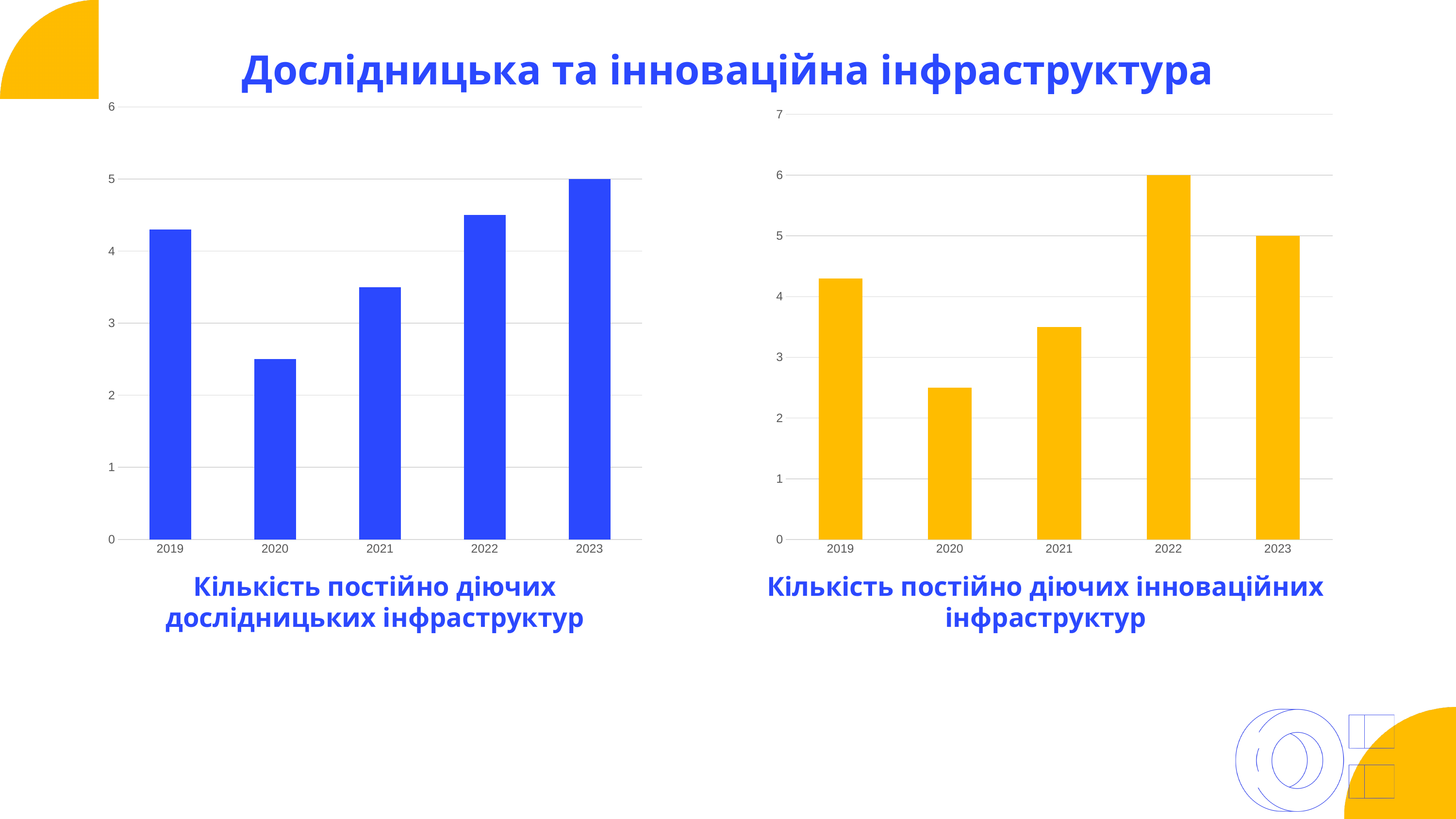
In the right chart (Кількість постійно діючих інноваційних інфраструктур), what is the value for 2023? 5 In the right chart (Кількість постійно діючих інноваційних інфраструктур), which year has the lowest value? 2020 In the left chart (Кількість постійно діючих дослідницьких інфраструктур), which is larger, the value for 2021 or the value for 2022? 2022 In the right chart (Кількість постійно діючих інноваційних інфраструктур), what is the difference between the values for 2022 and 2023? 1 In the left chart (Кількість постійно діючих дослідницьких інфраструктур), which year has the lowest value? 2020 In the left chart (Кількість постійно діючих дослідницьких інфраструктур), is the value for 2020 greater or less than 3? less In the right chart (Кількість постійно діючих інноваційних інфраструктур), which year has the highest value? 2022 In the left chart (Кількість постійно діючих дослідницьких інфраструктур), which year has the highest value? 2023 In the right chart (Кількість постійно діючих інноваційних інфраструктур), what is the value for 2022? 6 In the left chart (Кількість постійно діючих дослідницьких інфраструктур), what is the value for 2023? 5 How many years are shown on the x axis of the left chart (Кількість постійно діючих дослідницьких інфраструктур)? 5 In the right chart (Кількість постійно діючих інноваційних інфраструктур), is the value for 2019 greater or less than 4? greater